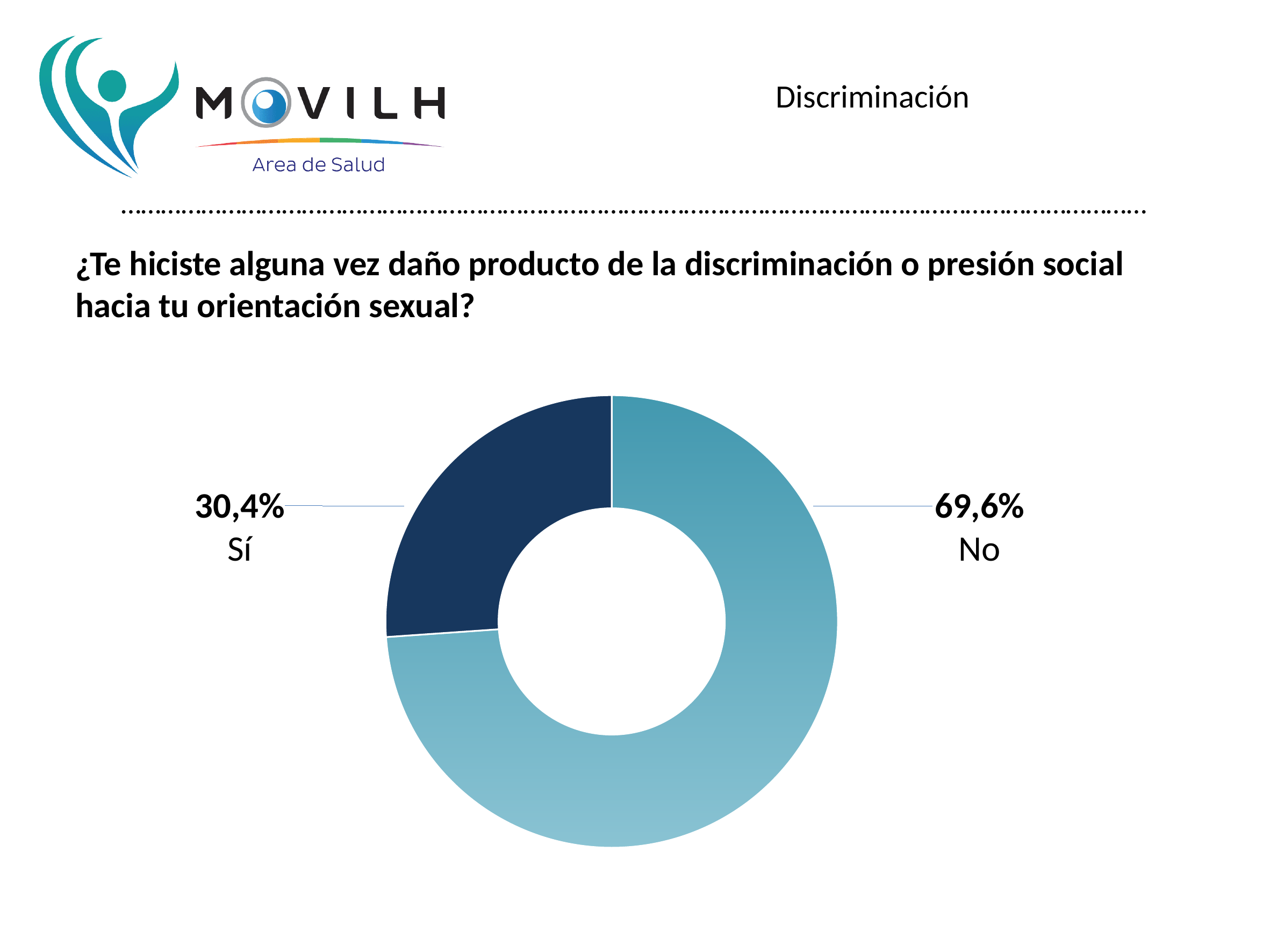
What is the total of the two percentages shown in the chart? 100% What percentage of respondents answered "Sí"? 30,4% What colour is the "Sí" segment of the chart? Dark navy blue Which response has the smallest share of the chart? Sí Which response has the largest share of the chart? No What question does the chart on the slide answer? ¿Te hiciste alguna vez daño producto de la discriminación o presión social hacia tu orientación sexual? What kind of chart is shown on the slide? Doughnut chart Which is larger, the share for "Sí" or the share for "No"? No What is the difference in percentage points between the "No" and "Sí" responses? 39,2 How many categories are shown in the chart? 2 What percentage of respondents answered "No"? 69,6%